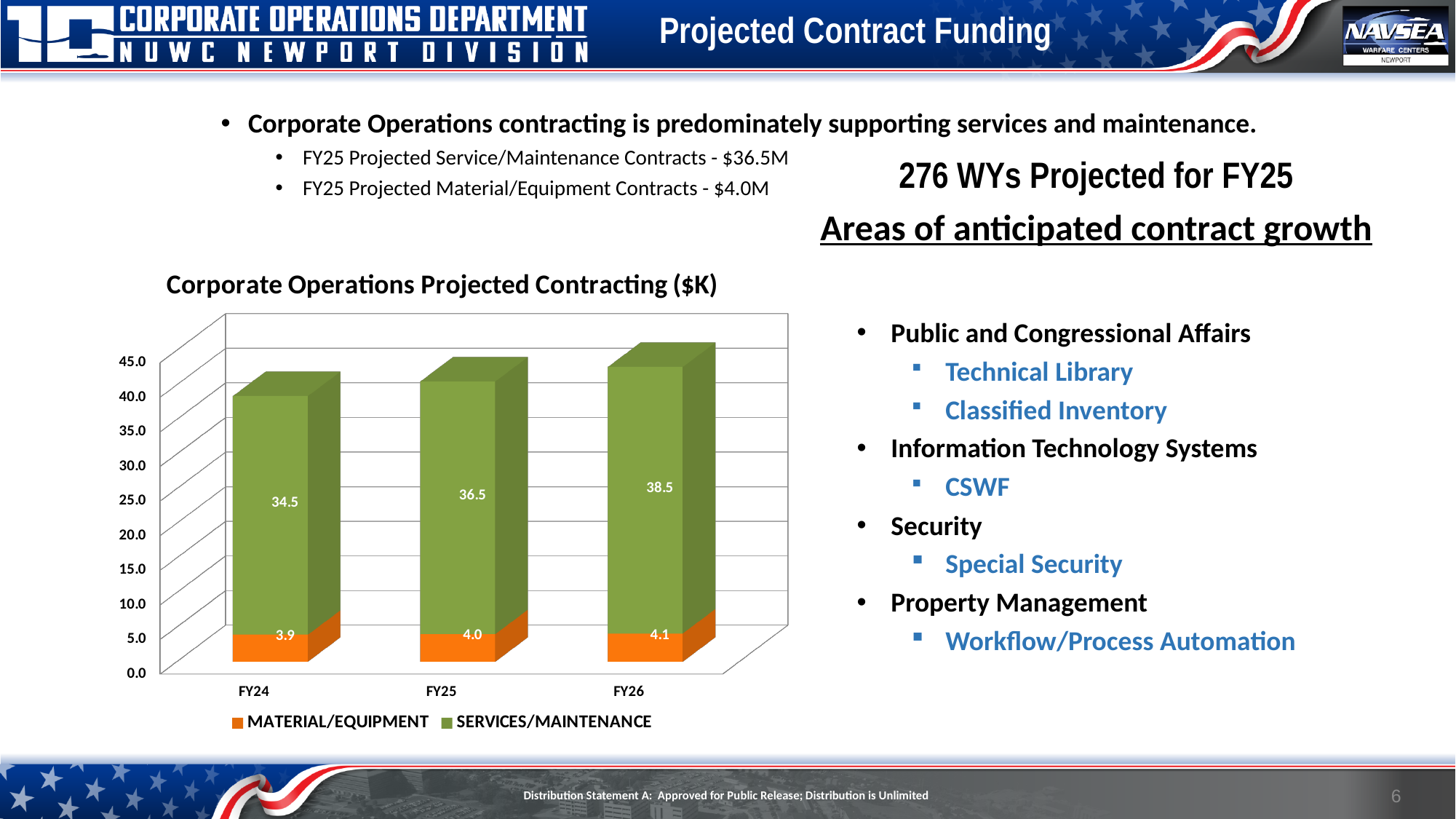
Which is larger, the SERVICES/MAINTENANCE value for FY24 or for FY25? FY25 What is the value for MATERIAL/EQUIPMENT in FY24? 3.9 Do the SERVICES/MAINTENANCE values rise or fall from FY24 to FY26? Rise How many fiscal years are shown on the x axis? 3 What is the total of the stacked bar for FY25? 40.5 What is the value for SERVICES/MAINTENANCE in FY25? 36.5 What kind of chart is shown? Stacked bar chart Which fiscal year has the lowest MATERIAL/EQUIPMENT value? FY24 What is the value for SERVICES/MAINTENANCE in FY26? 38.5 Which fiscal year has the highest SERVICES/MAINTENANCE value? FY26 What is the difference between the SERVICES/MAINTENANCE values for FY26 and FY24? 4.0 How many series does the legend list? 2